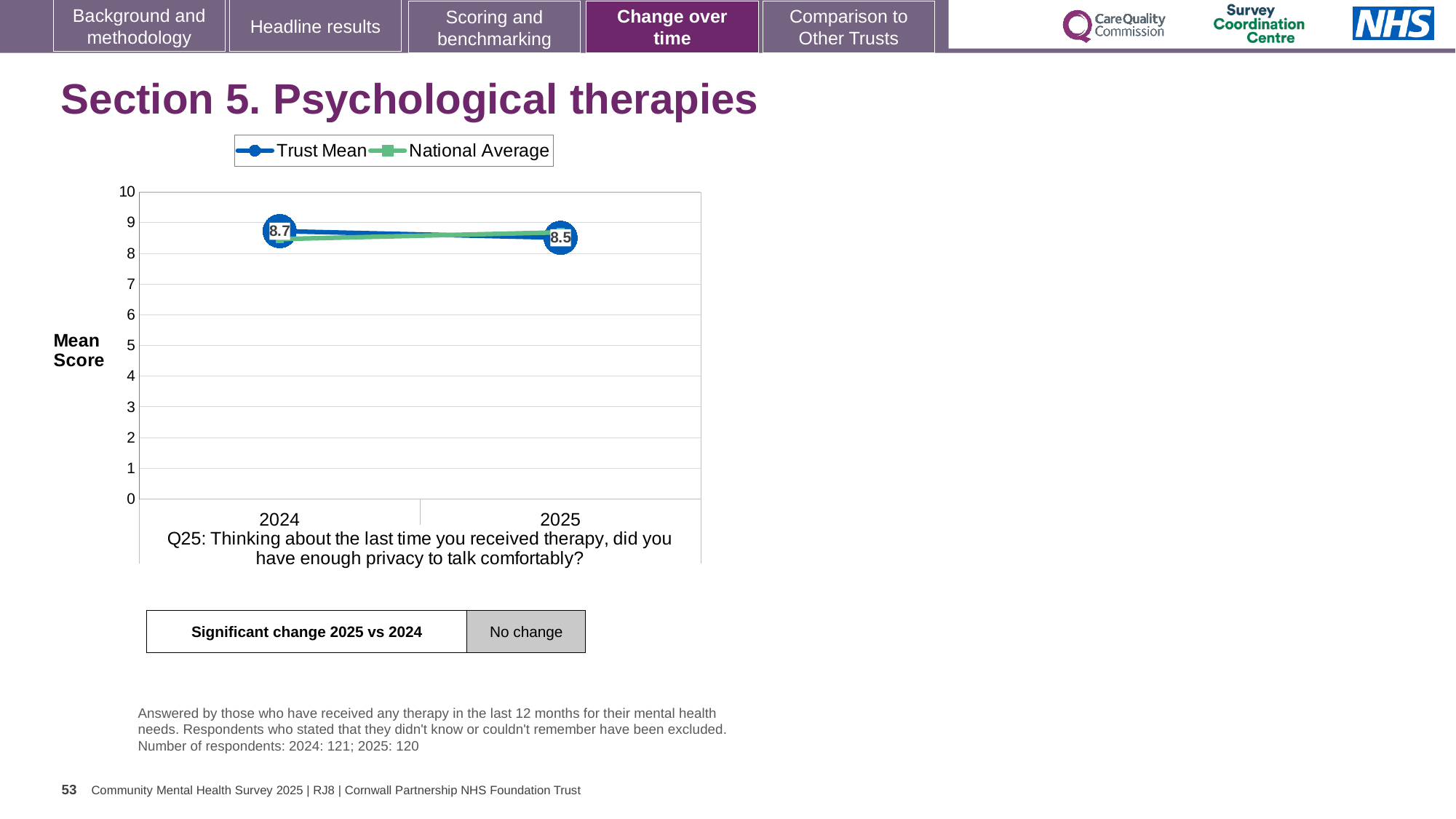
What is the Trust Mean score for 2024? 8.7 What is the label on the y axis of the chart? Mean Score Is the National Average value for 2024 greater or less than 8? greater What is the Trust Mean score for 2025? 8.5 By how much did the Trust Mean score change from 2024 to 2025? 0.2 How many series does the legend list? 2 In which year is the Trust Mean score highest? 2024 Is the National Average value for 2025 greater or less than 9? less How many years are plotted on the x axis? 2 Does the Trust Mean score rise or fall from 2024 to 2025? fall What kind of chart is shown on the slide? line chart Which year has the higher Trust Mean score, 2024 or 2025? 2024